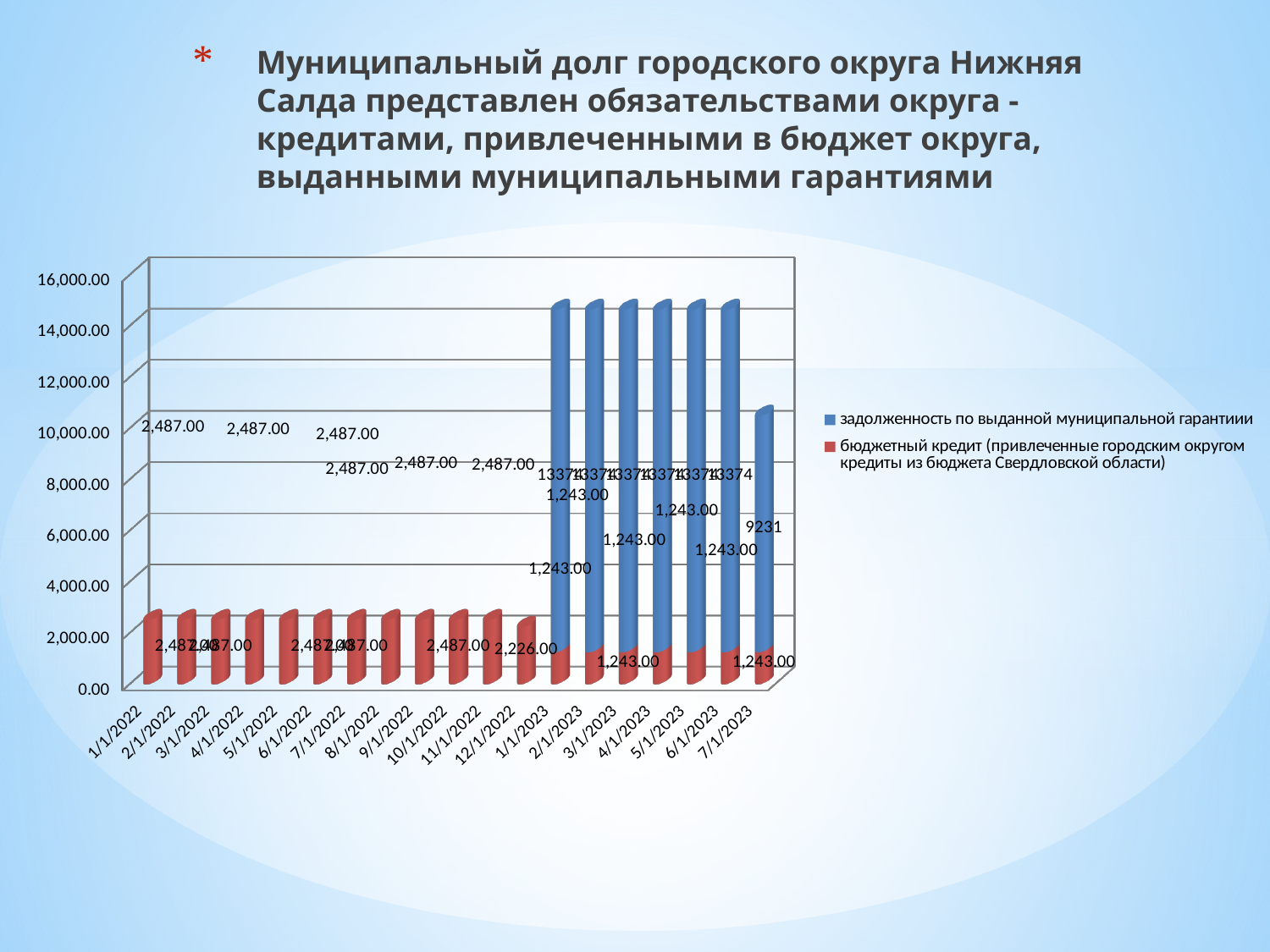
How many series does the legend list? 2 What is the value of the 'бюджетный кредит' series for 12/1/2022? 2,226.00 Does the 'бюджетный кредит' series rise or fall from 1/1/2022 to 7/1/2023? fall Which is larger for the 'бюджетный кредит' series: the value for 1/1/2022 or the value for 7/1/2023? 1/1/2022 What is the value of the 'бюджетный кредит' series for 1/1/2022? 2,487.00 What is the value of the 'бюджетный кредит' series for 7/1/2023? 1,243.00 What is the difference between the 'бюджетный кредит' values for 1/1/2022 and 12/1/2022? 261.00 What is the value of the 'задолженность по выданной муниципальной гарантии' series for 7/1/2023? 9231 What is the lowest value shown for the 'бюджетный кредит' series? 1,243.00 Which colour represents the 'задолженность по выданной муниципальной гарантии' series? blue What kind of chart is shown on the slide? bar chart How many dates are shown on the x axis? 19